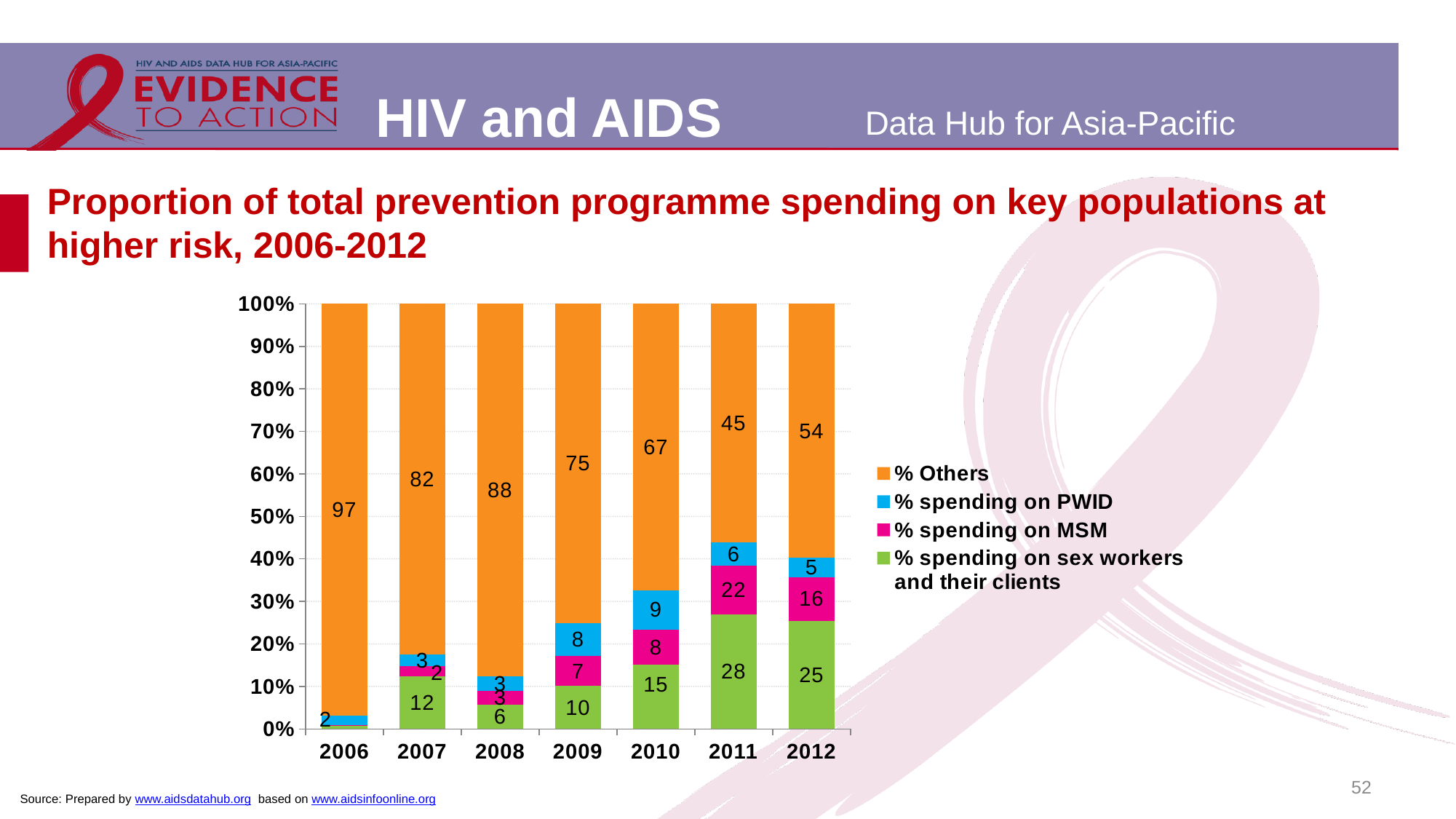
What is the value for % spending on MSM in 2012? 16 How many series does the chart legend list? 4 What type of chart is shown on the slide? Stacked bar chart How many years are shown on the x axis of the chart? 7 What is the difference between the % Others value in 2007 and in 2012? 28 What is the value for % Others in 2008? 88 In which year is the % Others value the lowest? 2011 In which year is the % spending on MSM value the highest? 2011 What is the value for % spending on PWID in 2010? 9 Which is larger: % spending on sex workers and their clients in 2009 or in 2010? 2010 What is the value for % spending on sex workers and their clients in 2011? 28 Does the % Others value generally rise or fall from 2006 to 2011? Fall